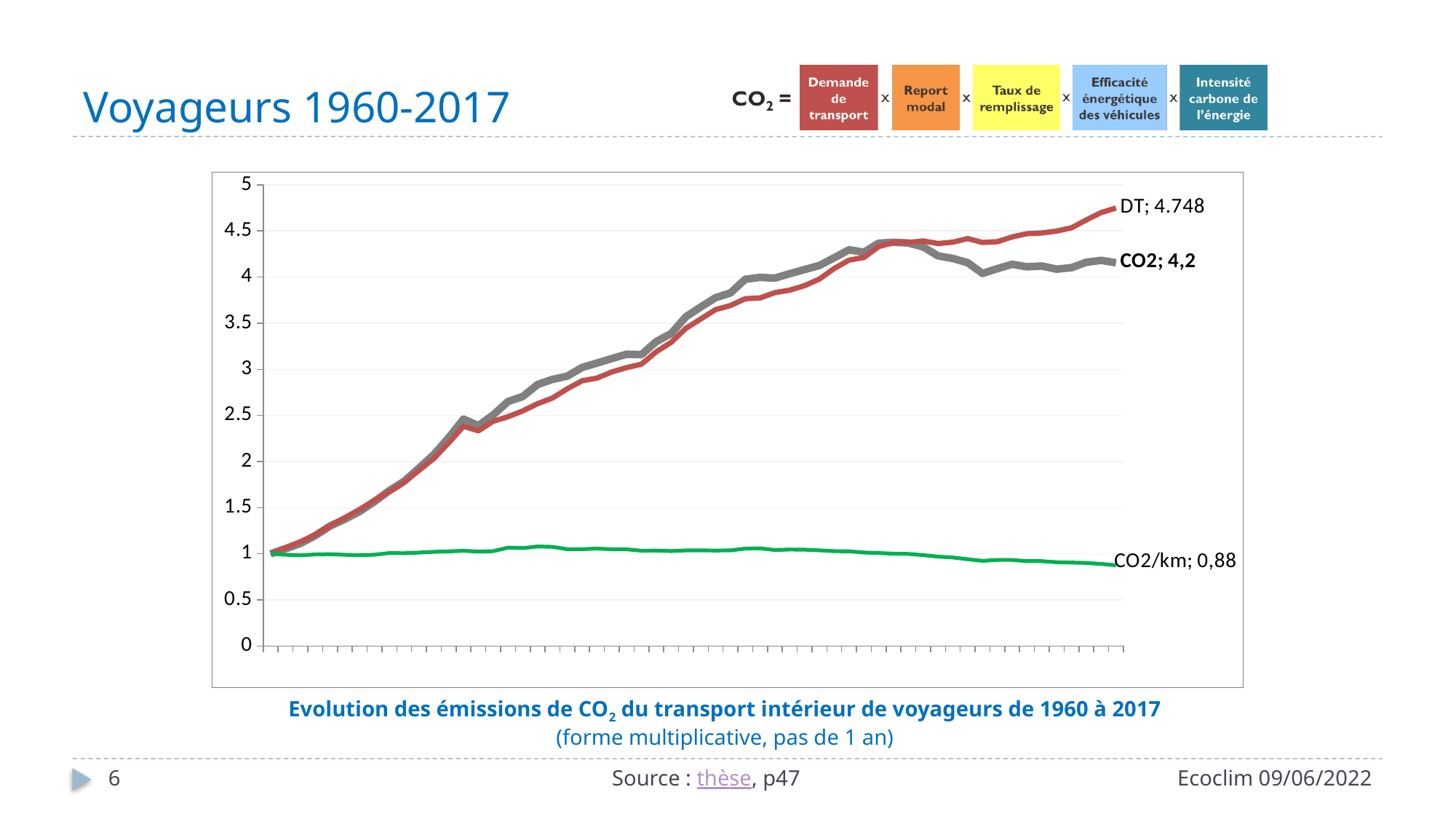
Which series ends at the highest value at the right of the chart? DT At the end of the chart, which is larger: the DT value or the CO2 value? DT What is the final value shown for the CO2 series? 4,2 What kind of chart is shown on the slide? line chart Which series ends at the lowest value at the right of the chart? CO2/km How many series (lines) are plotted on the chart? 3 What is the final value shown for the CO2/km series? 0,88 Is the final value of the CO2/km series greater or less than 1? less What is the final value shown for the DT series? 4.748 Does the DT series rise or fall overall from left to right? rise What is the difference between the final CO2 value (4,2) and the final CO2/km value (0,88)? 3,32 Is the final value of the DT series greater or less than 4.5? greater